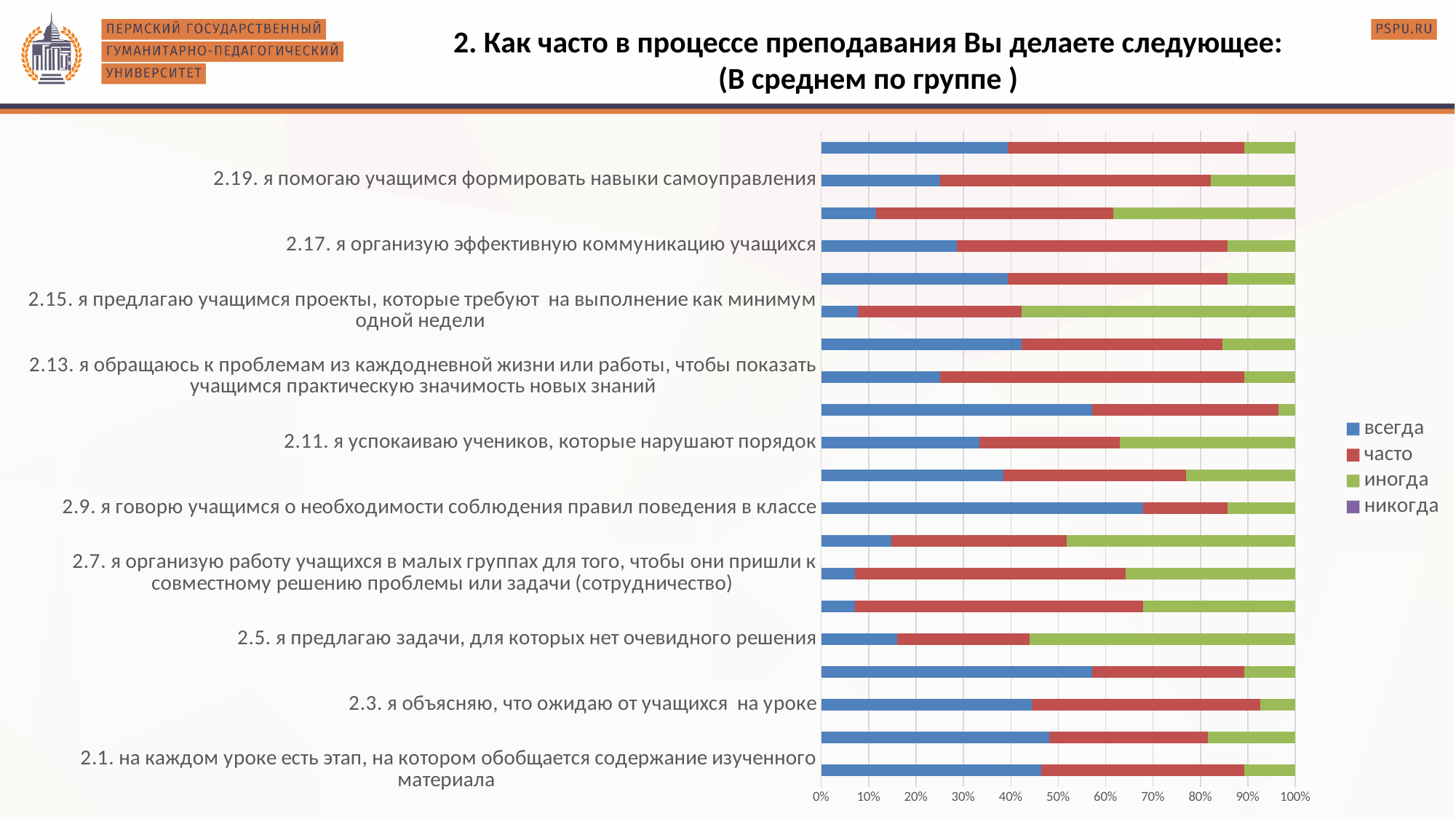
Which series is shown in blue in the chart legend? всегда Is the 'всегда' share for category 2.7 greater or less than 10%? less Which series is shown in green in the chart legend? иногда Which category has the larger 'иногда' share, 2.5 or 2.9? 2.5 How many series does the chart legend list? 4 Which category has the larger 'всегда' share, 2.3 or 2.13? 2.3 What kind of chart is shown on the slide? Stacked bar chart Is the 'всегда' share for category 2.15 greater or less than 10%? less Which category has the larger 'всегда' share, 2.9 or 2.7? 2.9 Is the 'всегда' share for category 2.1 greater or less than 40%? greater